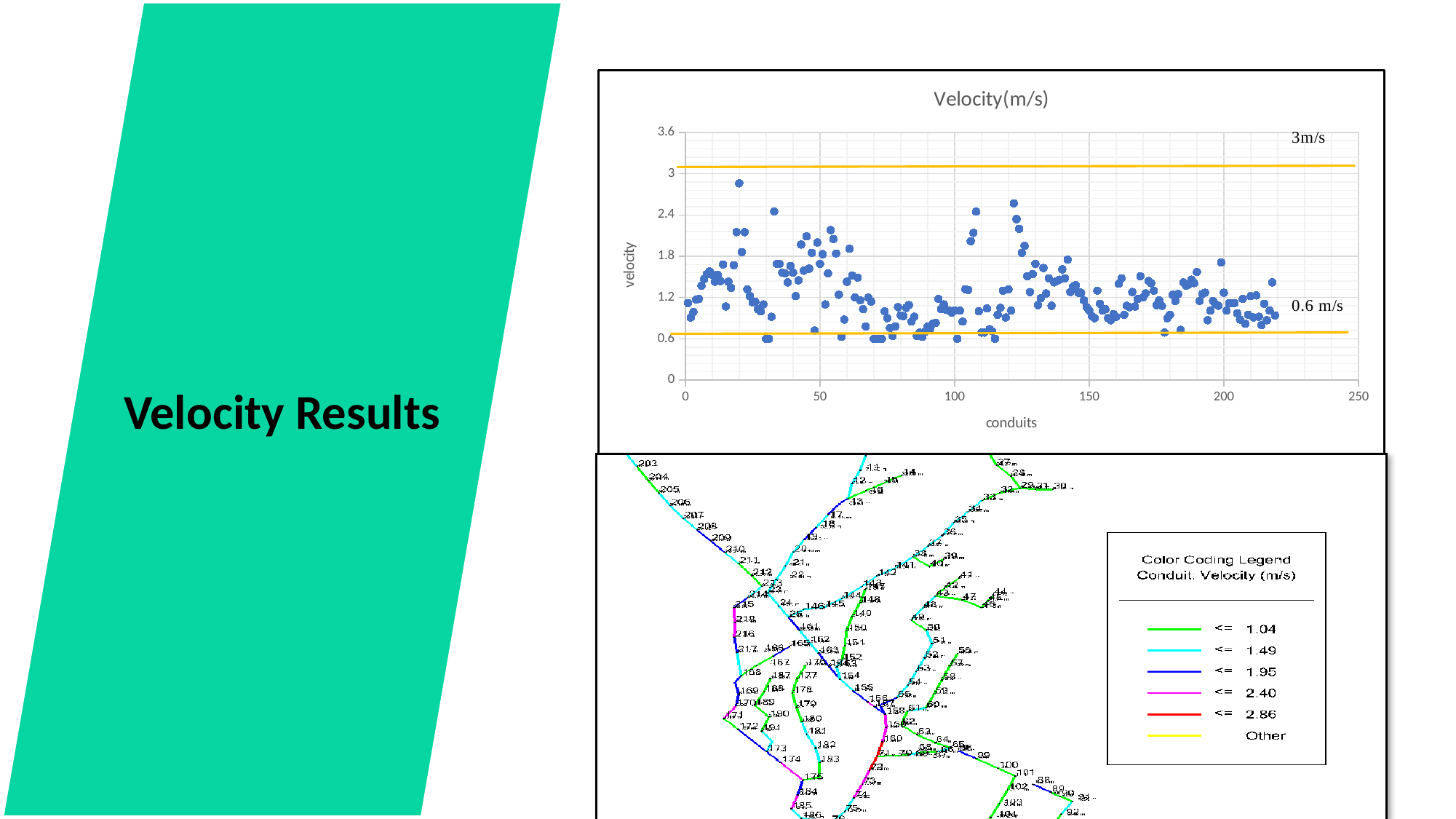
In the Velocity(m/s) chart, are most of the plotted points above or below the 1.8 gridline? below In the Velocity(m/s) chart, is the highest plotted velocity greater or less than 2.4? greater In the Velocity(m/s) chart, what value is labelled on the lower orange reference line? 0.6 m/s In the Velocity(m/s) chart, is the highest plotted velocity greater or less than 3? less In the Velocity(m/s) chart, what value is labelled on the upper orange reference line? 3m/s In the Color Coding Legend of the conduit map below the scatter chart, which colour represents conduit velocity <= 2.86? red In the Velocity(m/s) chart, what is the highest tick value shown on the y axis? 3.6 What kind of chart is the Velocity(m/s) chart at the top right of the slide? scatter chart In the Velocity(m/s) chart, what is the highest tick value shown on the x axis? 250 What is the title of the chart at the top right of the slide? Velocity(m/s)